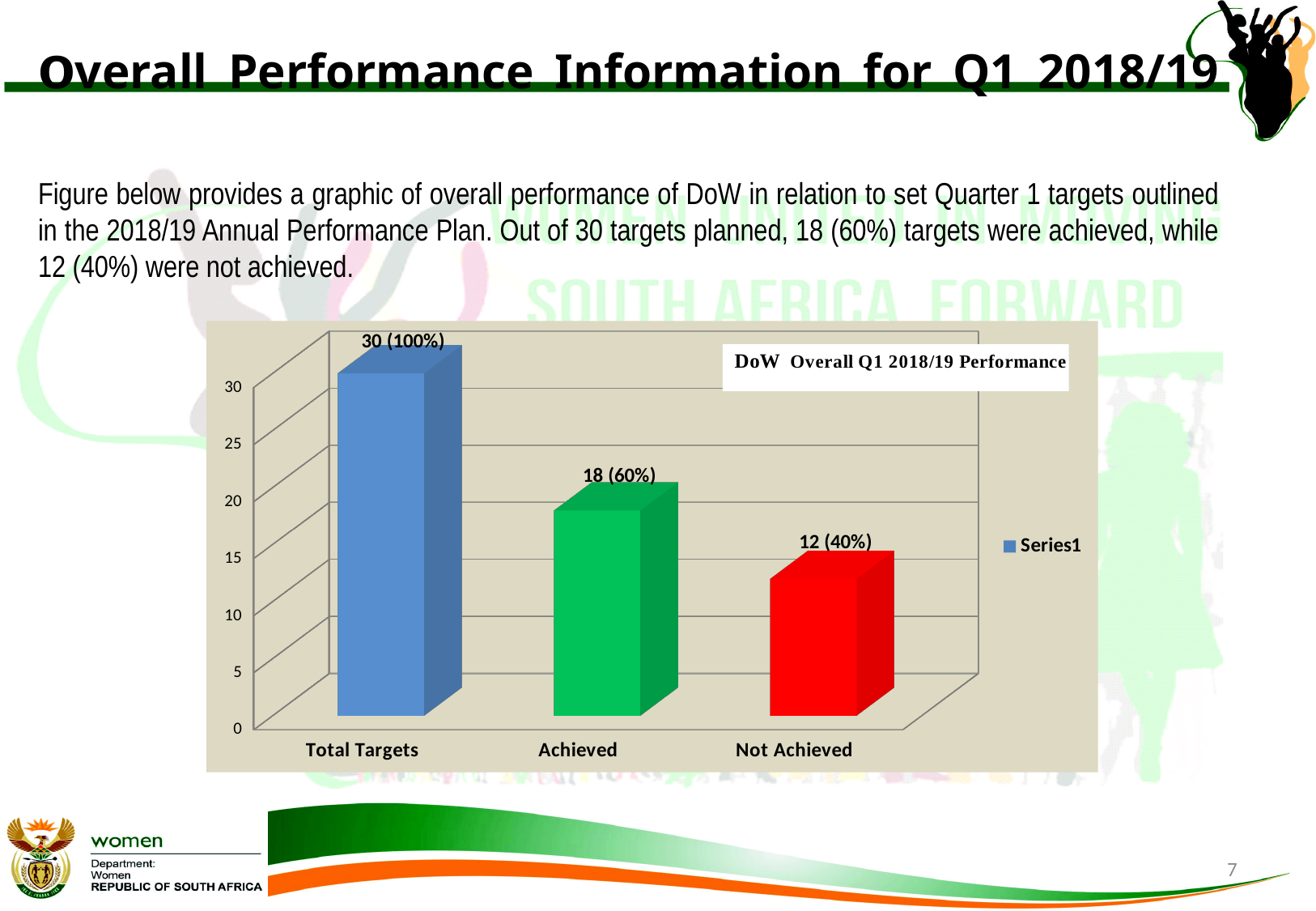
How many series does the legend list? 1 How many categories are shown on the x axis? 3 Which category has the highest value? Total Targets What is the value shown for Total Targets? 30 (100%) What kind of chart is shown on the slide? Bar chart What is the title of the chart? DoW Overall Q1 2018/19 Performance Which category has the lowest value? Not Achieved What is the value shown for Not Achieved? 12 (40%) Is the value for Achieved greater or less than 15? greater What is the difference between the Achieved and Not Achieved values? 6 Which is larger, the value for Achieved or the value for Not Achieved? Achieved What is the value shown for Achieved? 18 (60%)